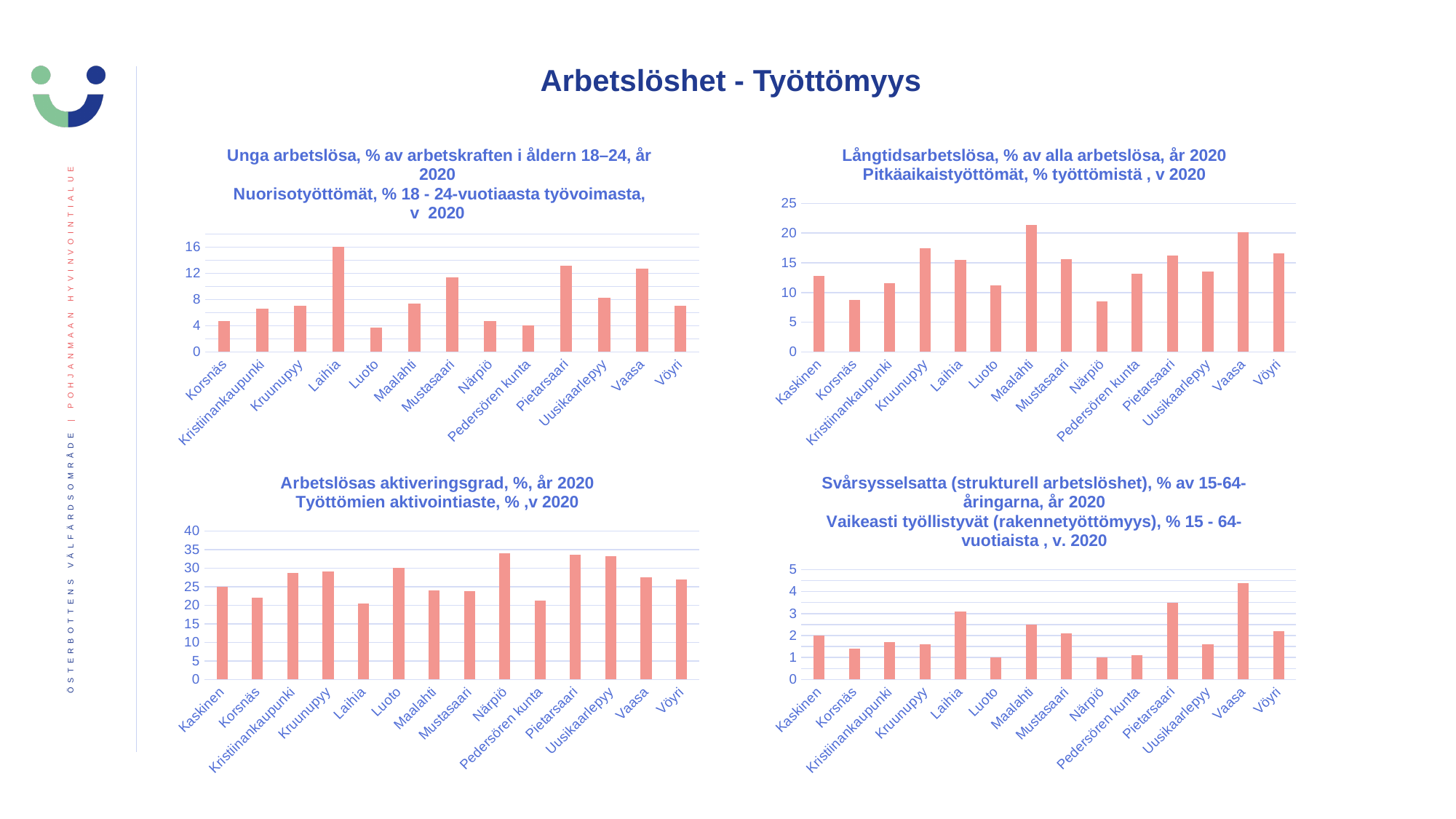
What type of chart is used for 'Unga arbetslösa, % av arbetskraften i åldern 18–24, år 2020' (top-left)? bar chart In the bottom-right chart (Svårsysselsatta), which municipality has the highest value? Vaasa In the top-left chart (Unga arbetslösa), how many municipalities are shown on the x axis? 13 In the top-right chart (Långtidsarbetslösa), is the value for Vaasa greater or less than 15? greater In the top-right chart (Långtidsarbetslösa), which municipality has the highest value? Maalahti In the bottom-left chart (Arbetslösas aktiveringsgrad), which is larger, the value for Luoto or the value for Korsnäs? Luoto In the bottom-left chart (Arbetslösas aktiveringsgrad), is the value for Laihia greater or less than 25? less In the top-right chart (Långtidsarbetslösa), how many municipalities are shown on the x axis? 14 In the top-left chart (Unga arbetslösa), which municipality has the highest value? Laihia How many charts are shown on the slide? 4 In the top-left chart (Unga arbetslösa), is the value for Pietarsaari greater or less than 12? greater In the top-left chart (Unga arbetslösa), which is larger, the value for Mustasaari or the value for Närpiö? Mustasaari